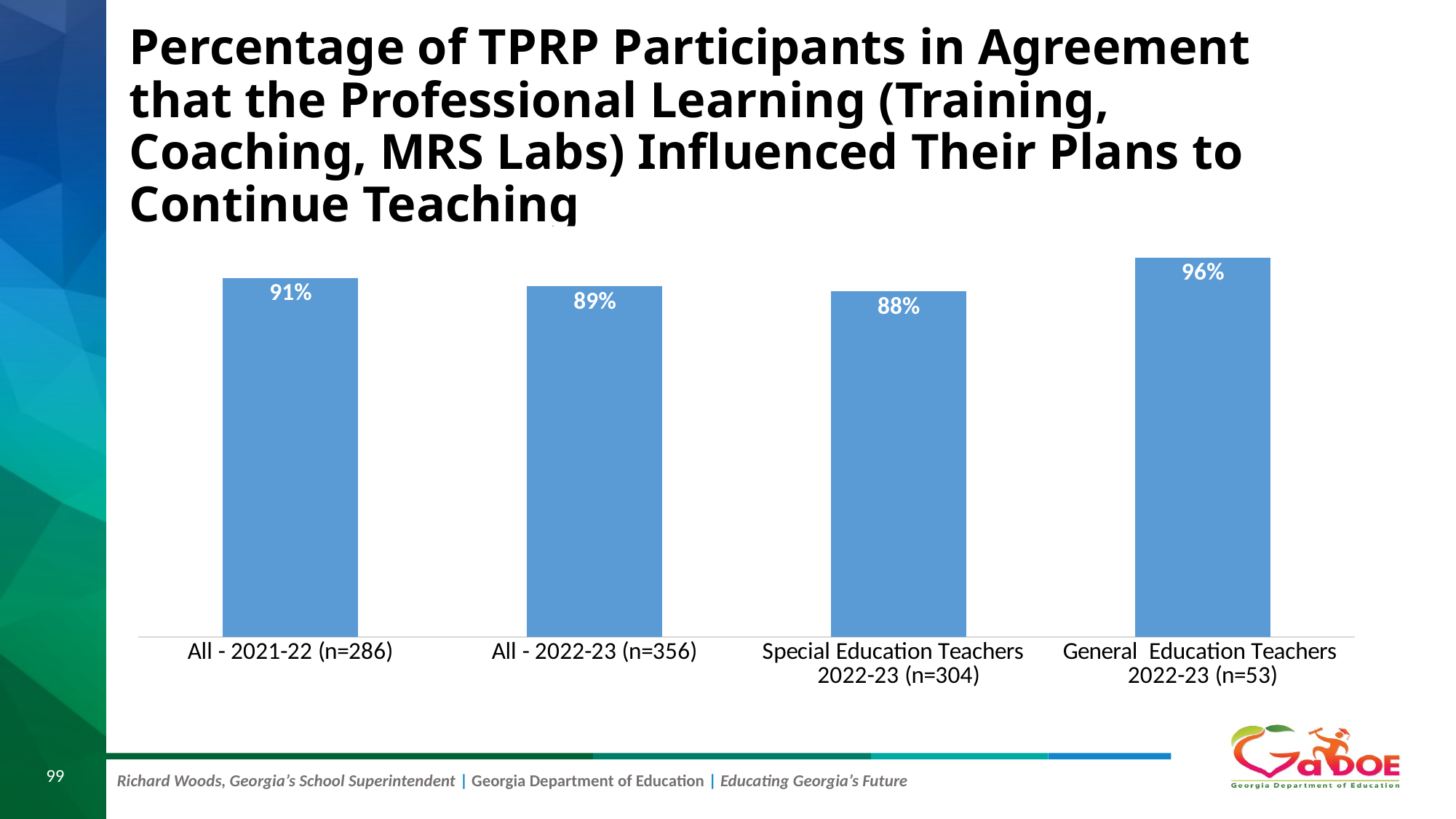
How many categories are shown in the chart? 4 What is the difference between the values for General Education Teachers 2022-23 (n=53) and Special Education Teachers 2022-23 (n=304)? 8% Which is larger, the value for All - 2021-22 (n=286) or the value for General Education Teachers 2022-23 (n=53)? General Education Teachers 2022-23 (n=53) What is the value for Special Education Teachers 2022-23 (n=304)? 88% What colour are the bars in the chart? Blue What is the value for General Education Teachers 2022-23 (n=53)? 96% What is the value for All - 2021-22 (n=286)? 91% Which category has the highest value? General Education Teachers 2022-23 (n=53) What is the value for All - 2022-23 (n=356)? 89% What kind of chart is shown on the slide? Bar chart What is the difference between the values for All - 2021-22 (n=286) and All - 2022-23 (n=356)? 2% Which category has the lowest value? Special Education Teachers 2022-23 (n=304)